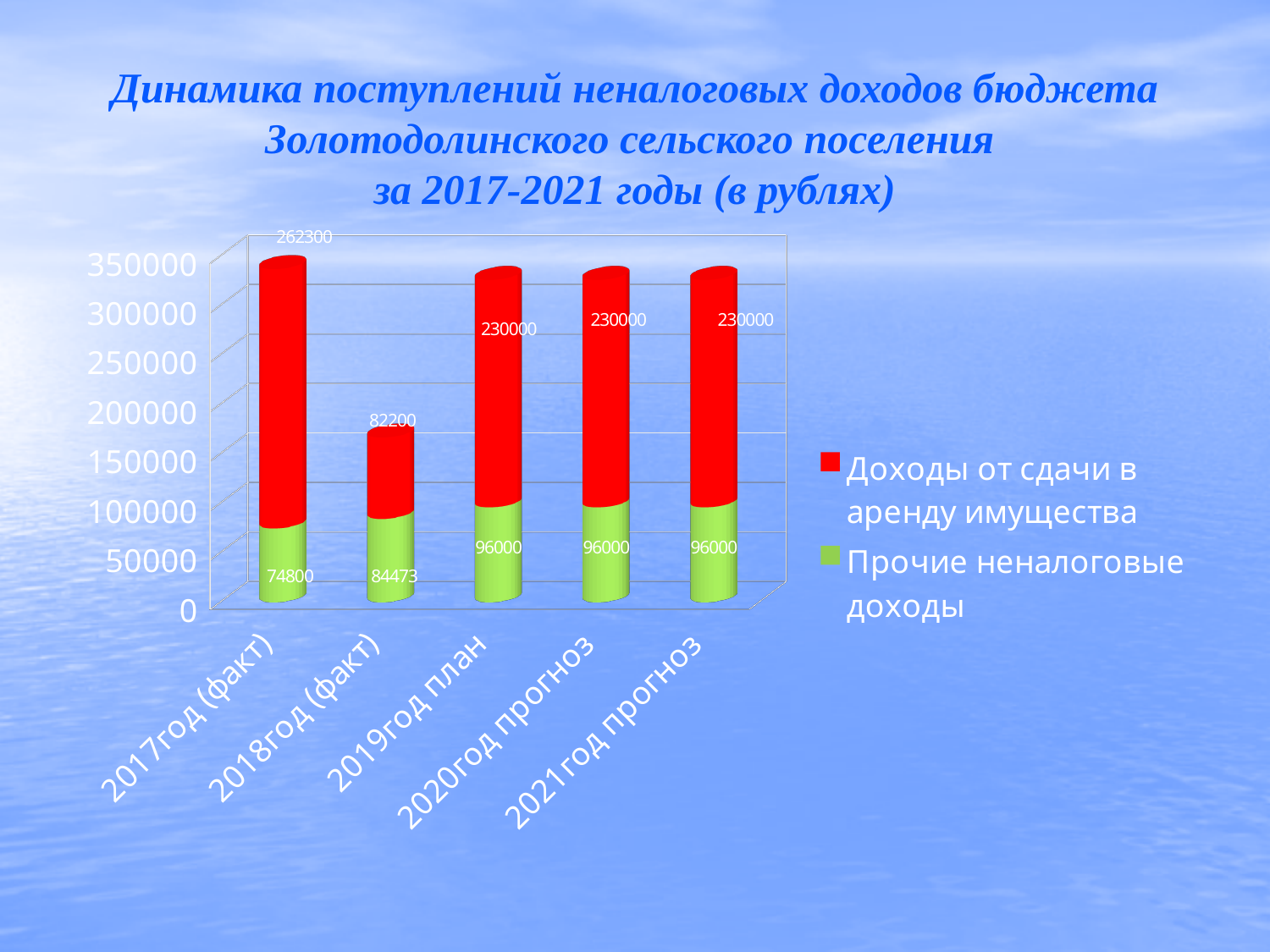
Which category has the highest value for Доходы от сдачи в аренду имущества? 2017год (факт) Which category has the lowest value for Прочие неналоговые доходы? 2017год (факт) What is the total of the stacked bar for 2018год (факт)? 166673 What is the value of Прочие неналоговые доходы for 2018год (факт)? 84473 What is the value of Доходы от сдачи в аренду имущества for 2017год (факт)? 262300 How many categories are shown on the x axis? 5 What is the value of Прочие неналоговые доходы for 2019год план? 96000 What is the total of the stacked bar for 2020год прогноз? 326000 Which is larger: Прочие неналоговые доходы in 2018год (факт) or in 2017год (факт)? 2018год (факт) How many series does the legend list? 2 What is the value of Доходы от сдачи в аренду имущества for 2021год прогноз? 230000 What is the difference between Доходы от сдачи в аренду имущества in 2017год (факт) and 2018год (факт)? 180100